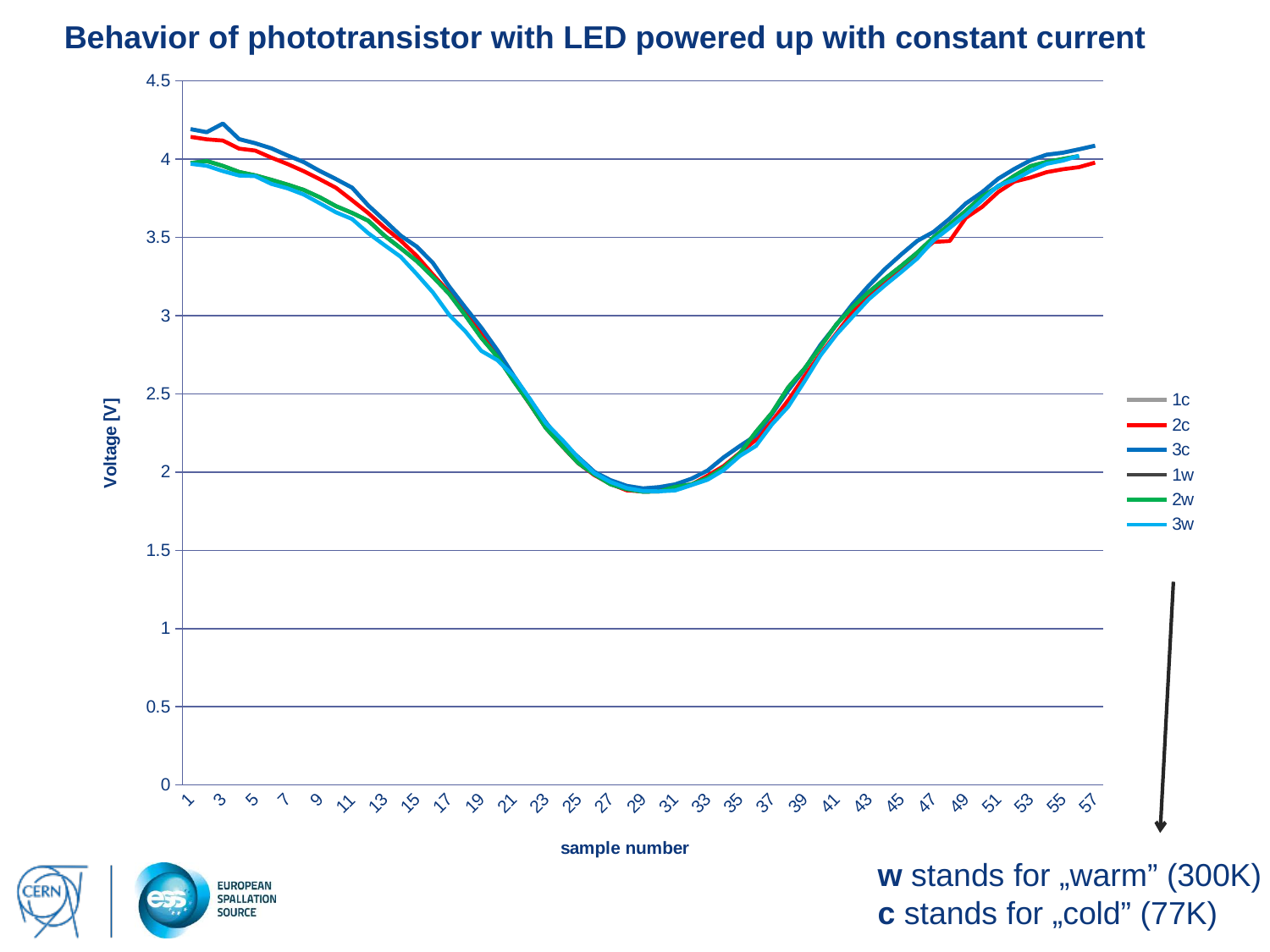
Is the value for series 3c at sample number 1 greater or less than 4? greater What is the title of the chart? Behavior of phototransistor with LED powered up with constant current Is the value for series 2c at sample number 37 greater or less than 2.5? less How many series does the legend list? 6 Do the values rise or fall from sample number 29 to sample number 57? rise Is the value for series 3c at sample number 11 greater or less than 3.5? greater What kind of chart is shown on the slide? line chart At sample number 1, which series has the larger value, 3c or 3w? 3c What is the label of the vertical axis? Voltage [V] Do the values rise or fall from sample number 1 to sample number 29? fall